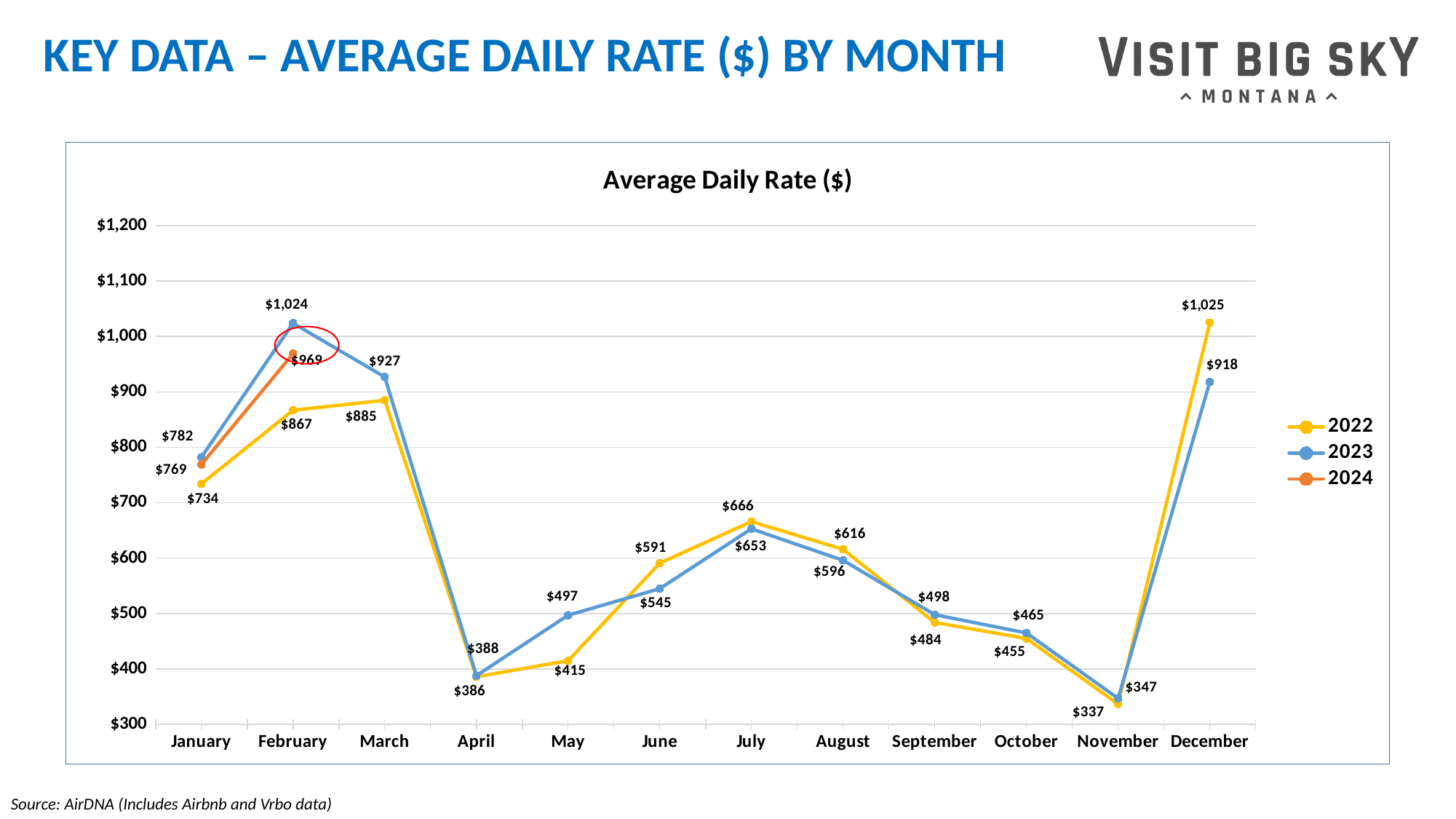
How many months are shown on the x axis? 12 What was the average daily rate in May 2023? $497 In which month was the 2023 average daily rate highest? February For how many months does the 2024 series show data? 2 What was the average daily rate in December 2022? $1,025 How much lower was the February 2024 average daily rate than the February 2023 rate? $55 In which month was the 2022 average daily rate lowest? November Which year had the higher average daily rate in June, 2022 or 2023? 2022 What kind of chart is shown on the slide? Line chart How many series does the legend list? 3 What was the average daily rate in February 2023? $1,024 What was the average daily rate in February 2024? $969